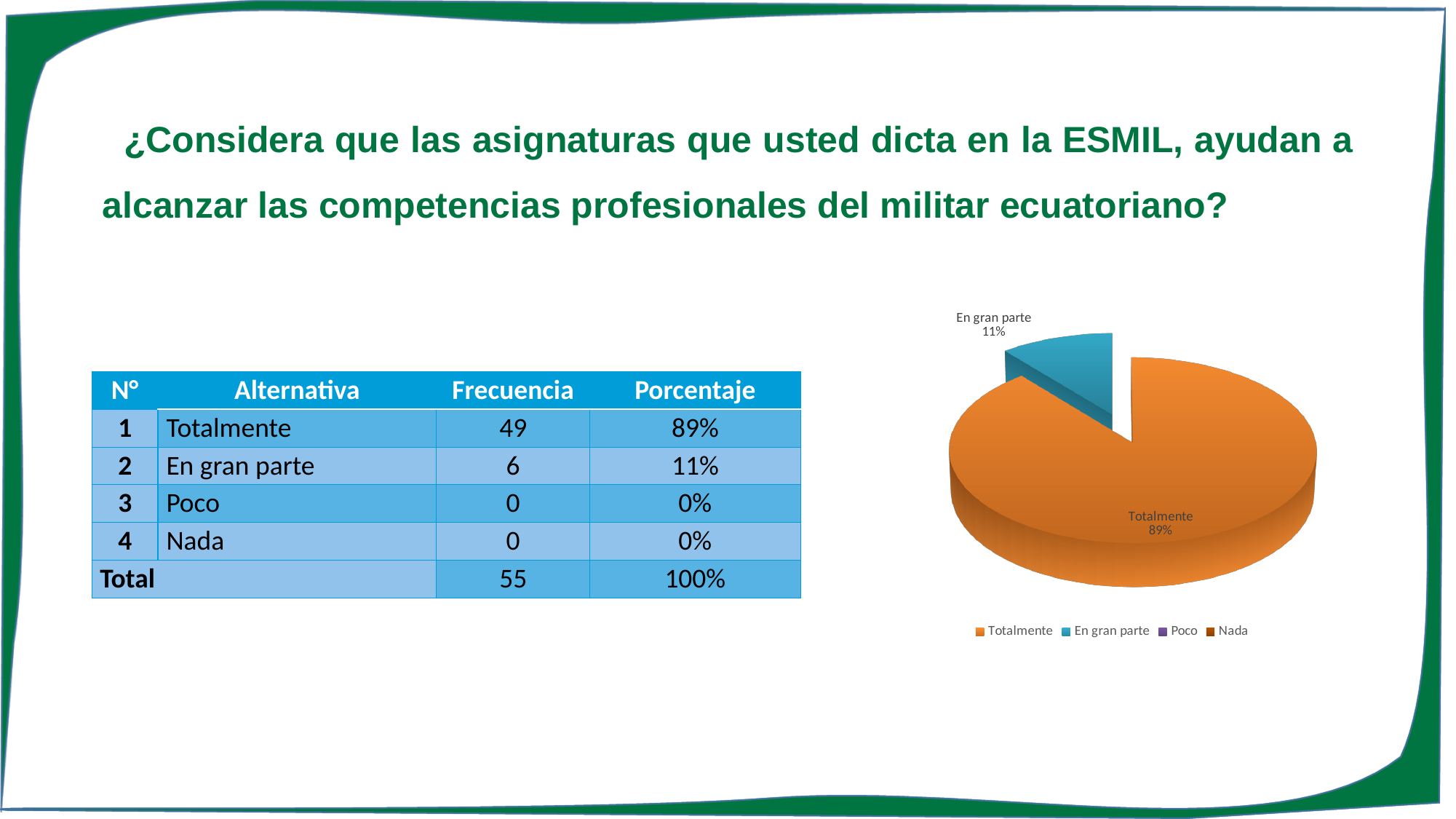
How many entries does the pie chart's legend list? 4 Is the share for Totalmente greater or less than 50%? greater What share of the pie does the Totalmente slice represent? 89% Which legend entry is shown in blue? En gran parte How many slices are visibly drawn in the pie chart? 2 Is the share for En gran parte greater or less than 50%? less What colour is the Totalmente slice in the pie chart? orange What share of the pie does the En gran parte slice represent? 11% Which slice is larger, Totalmente or En gran parte? Totalmente Which category has the largest slice in the pie chart? Totalmente What is the difference in percentage points between the Totalmente and En gran parte slices? 78% What kind of chart is shown on the slide? pie chart